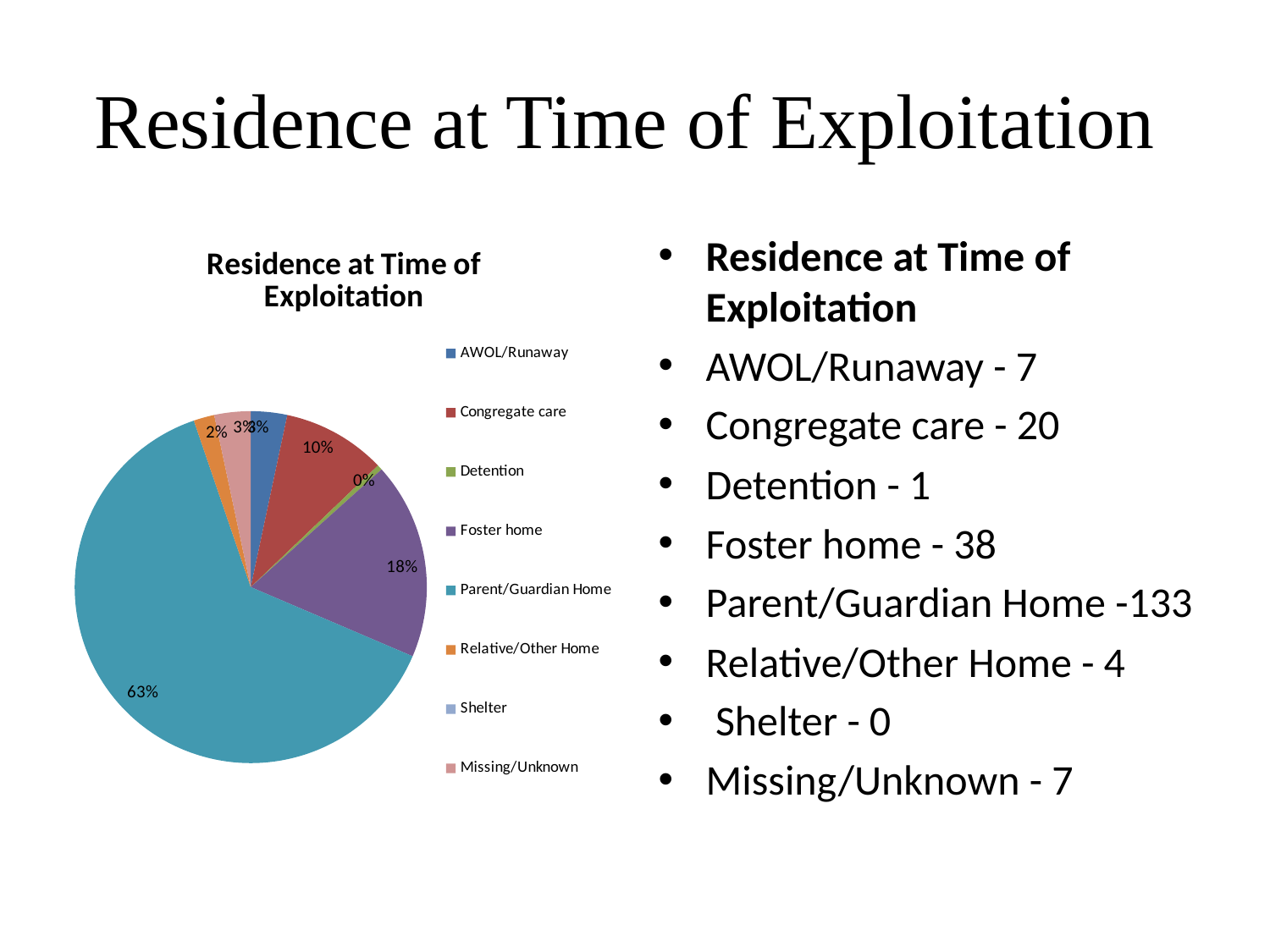
What share of the pie does Parent/Guardian Home represent? 63% Which category has the largest slice of the pie? Parent/Guardian Home Which slice is larger, Foster home or Congregate care? Foster home How many categories does the chart's legend list? 8 What percentage is shown for Foster home? 18% What percentage is shown for Detention? 0% What percentage is shown for Congregate care? 10% What is the difference in percentage points between Parent/Guardian Home and Foster home? 45 What is the title of the chart? Residence at Time of Exploitation Which category is listed first in the legend? AWOL/Runaway What percentage is shown for Relative/Other Home? 2% What kind of chart is shown on the slide? pie chart